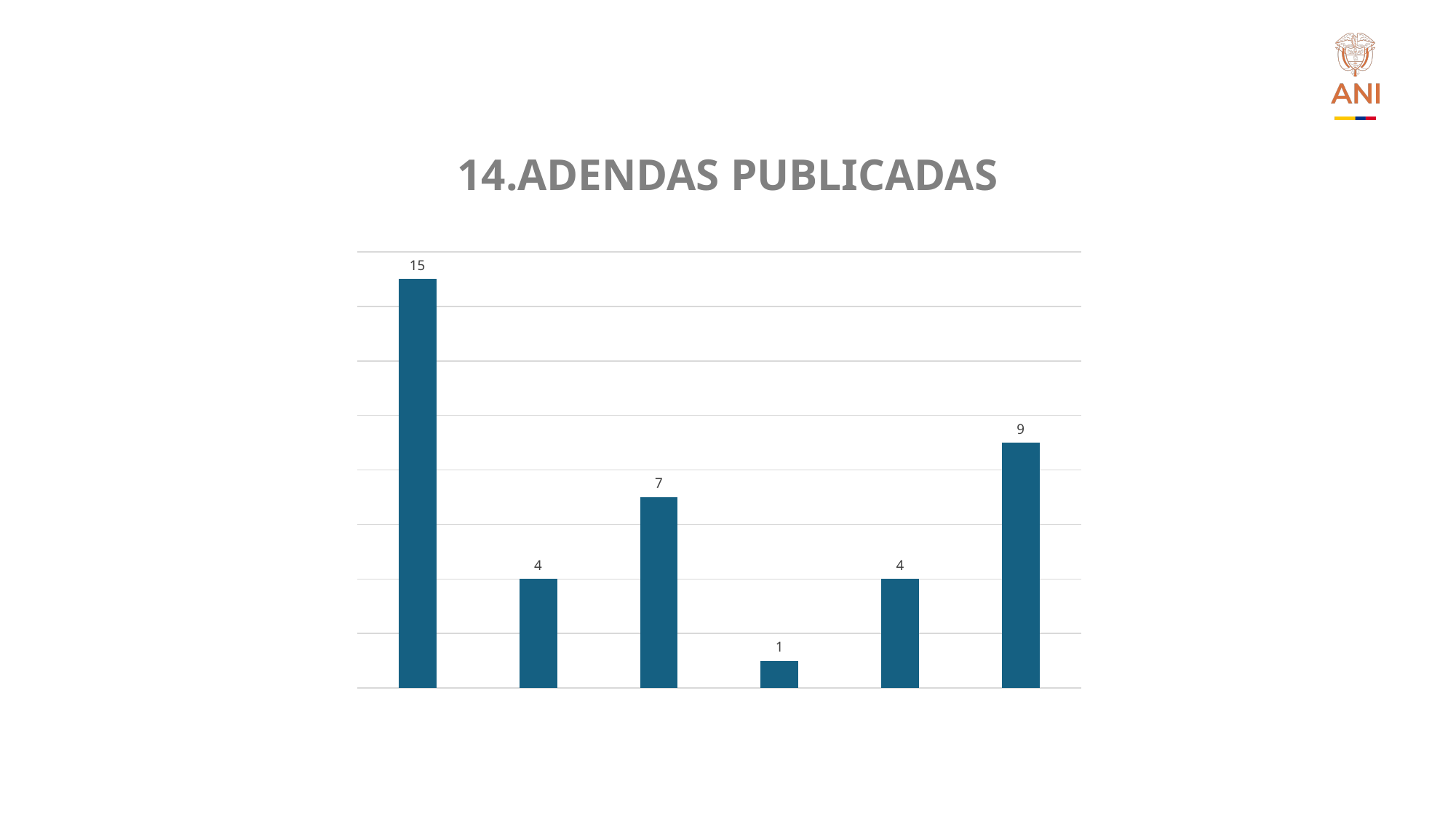
What is the title of the chart on the slide? 14.ADENDAS PUBLICADAS Which is larger, the third bar from the left or the rightmost bar? The rightmost bar (9) What is the value of the third bar from the left in the chart? 7 What is the highest value shown in the chart? 15 How many bars are plotted in the chart? 6 What is the value of the fourth bar from the left in the chart? 1 What is the total of all the bar values in the chart? 40 What is the value of the last (rightmost) bar in the chart? 9 What type of chart is shown on the slide? Bar chart What is the difference between the first bar (15) and the last bar (9)? 6 What is the value of the first (leftmost) bar in the chart? 15 What is the lowest value shown in the chart? 1